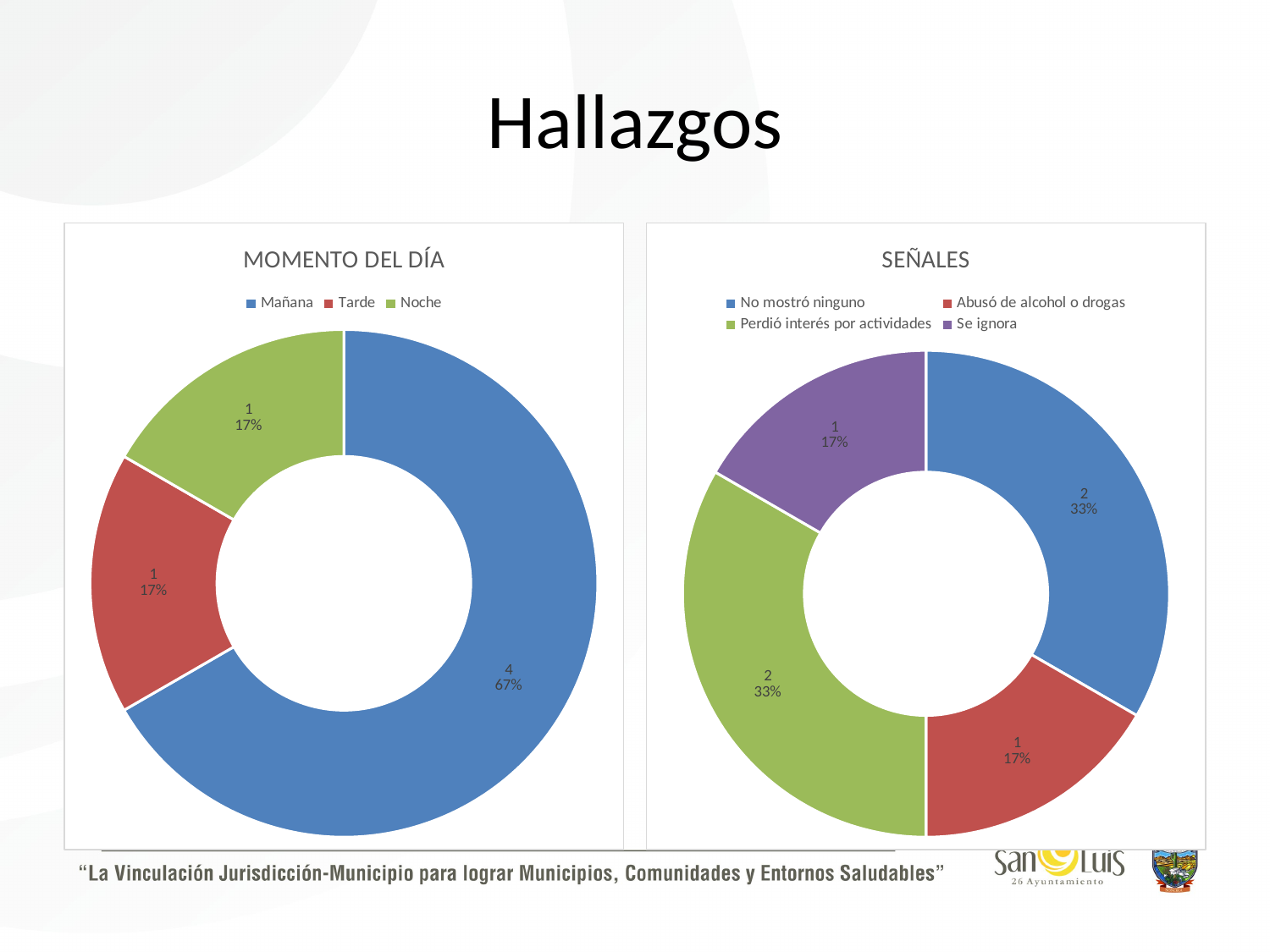
In the SEÑALES chart, how many entries does the legend list? 4 In the SEÑALES chart, what share of the pie does Perdió interés por actividades represent? 33% In the MOMENTO DEL DÍA chart, what share of the pie does Mañana represent? 67% In the MOMENTO DEL DÍA chart, what is the value for Mañana? 4 In the SEÑALES chart, what is the value for Abusó de alcohol o drogas? 1 In the SEÑALES chart, what colour is the Se ignora slice? Purple What kind of chart is the MOMENTO DEL DÍA chart? Doughnut chart In the MOMENTO DEL DÍA chart, which category has the highest value? Mañana In the MOMENTO DEL DÍA chart, what is the difference between the values for Mañana and Tarde? 3 In the SEÑALES chart, which is larger, the value for No mostró ninguno or the value for Se ignora? No mostró ninguno In the MOMENTO DEL DÍA chart, how many categories are shown? 3 In the SEÑALES chart, what is the difference between the values for No mostró ninguno and Abusó de alcohol o drogas? 1